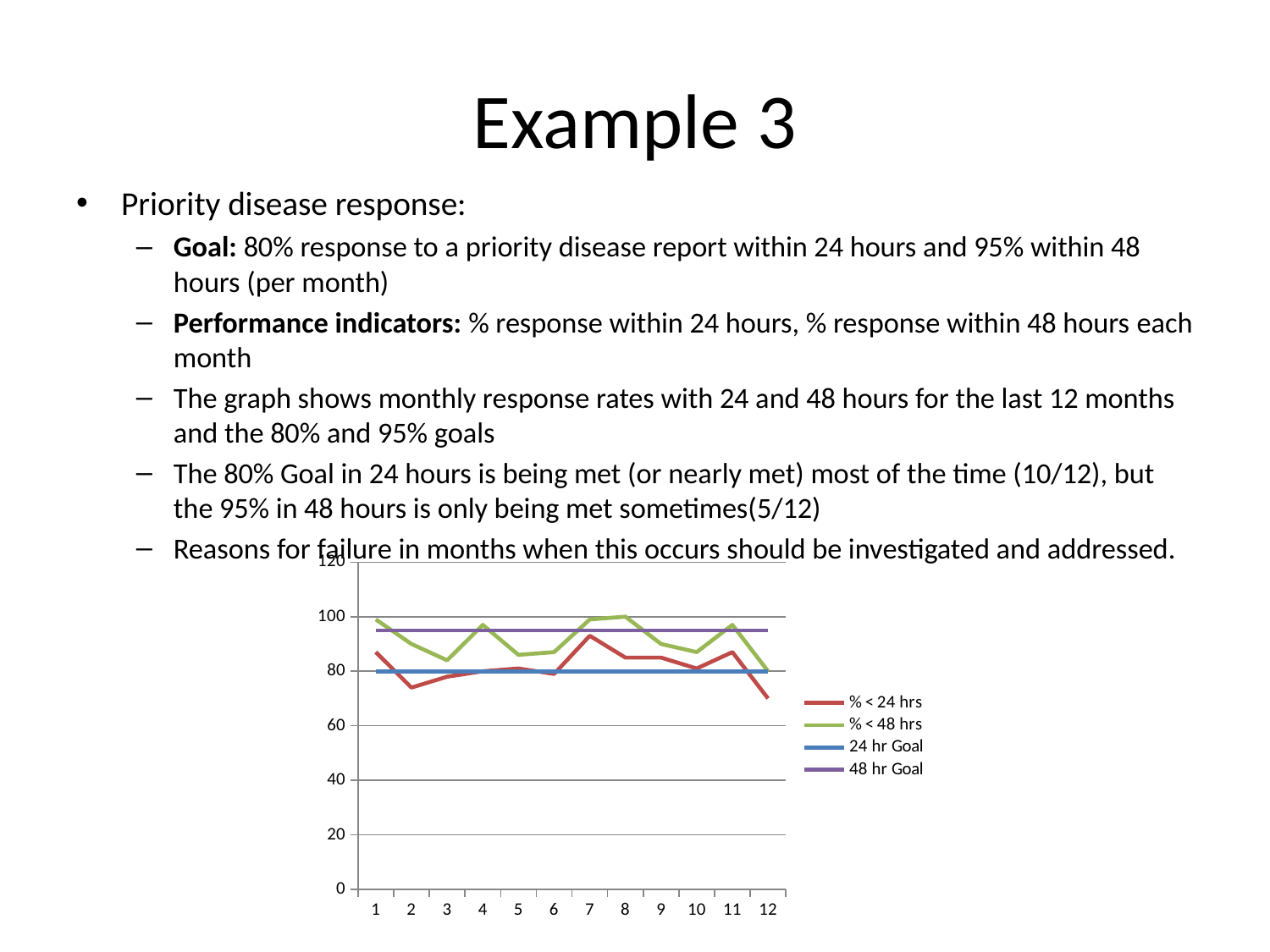
In which month is the % < 24 hrs series at its highest? 7 In month 12, which series is higher: % < 24 hrs or % < 48 hrs? % < 48 hrs Is the value for % < 24 hrs in month 7 greater or less than 80? greater In which month is the % < 24 hrs series at its lowest? 12 What colour is the 24 hr Goal line in the chart? blue Does the % < 24 hrs series rise or fall from month 11 to month 12? fall Is the value for % < 48 hrs in month 1 greater or less than 80? greater How many months (x-axis points) are plotted on the chart? 12 What value does the 24 hr Goal line sit at on the chart? 80 Is the value for % < 24 hrs in month 12 greater or less than 80? less How many series does the chart legend list? 4 What kind of chart is shown on the slide? line chart